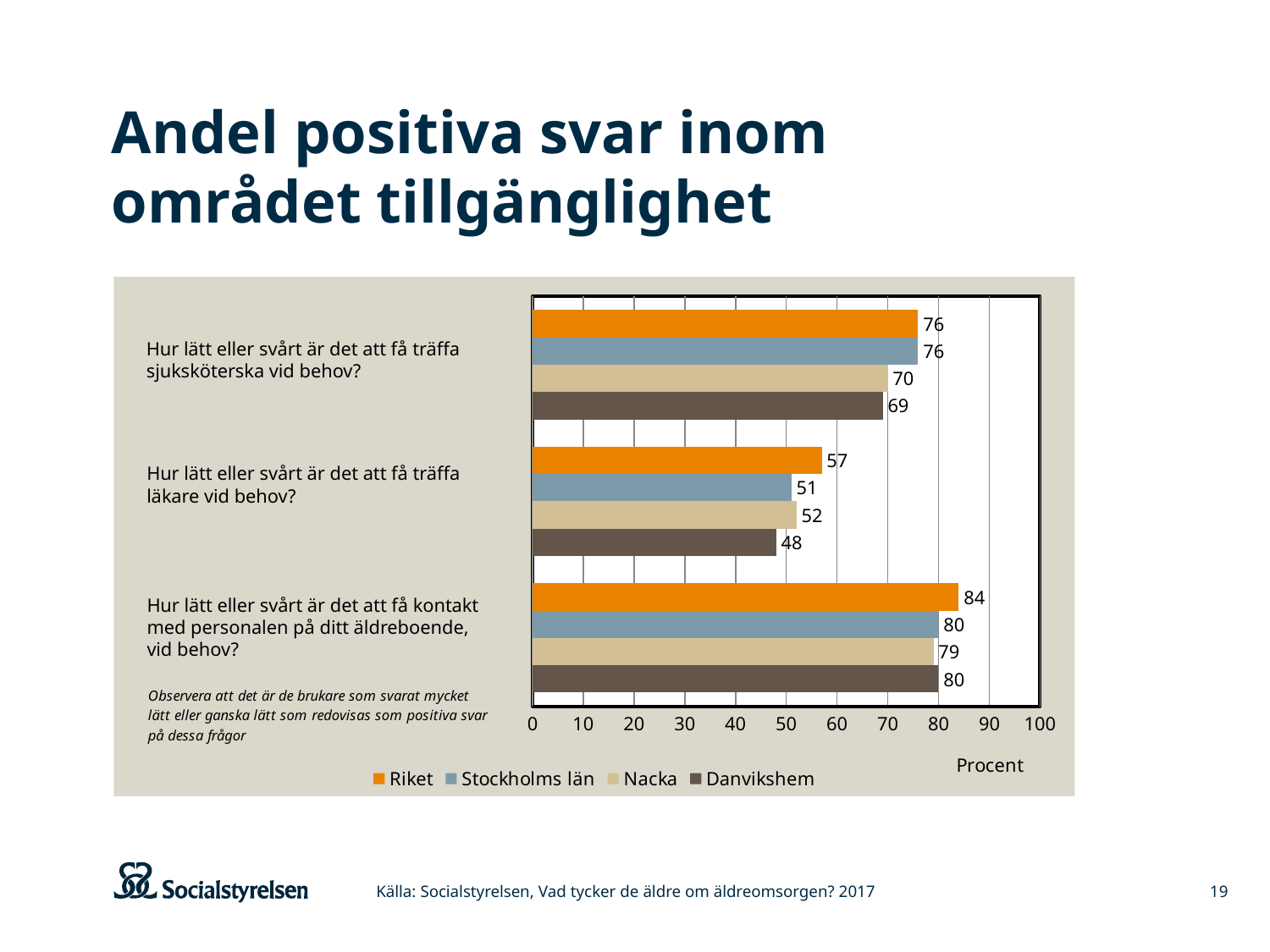
Which is larger for Danvikshem: the value for "Hur lätt eller svårt är det att få träffa sjuksköterska vid behov?" or for "Hur lätt eller svårt är det att få kontakt med personalen på ditt äldreboende, vid behov?"? Hur lätt eller svårt är det att få kontakt med personalen på ditt äldreboende, vid behov? How many series does the legend list? 4 Is the value for Stockholms län on the question "Hur lätt eller svårt är det att få träffa läkare vid behov?" greater or less than 60? less What is the value for Nacka on the question "Hur lätt eller svårt är det att få kontakt med personalen på ditt äldreboende, vid behov?"? 79 What kind of chart is shown on the slide? bar chart Which series has the highest value on the question "Hur lätt eller svårt är det att få kontakt med personalen på ditt äldreboende, vid behov?"? Riket What is the value for Riket on the question "Hur lätt eller svårt är det att få träffa läkare vid behov?"? 57 How many questions (categories) are shown on the chart? 3 Which series has the lowest value on the question "Hur lätt eller svårt är det att få träffa läkare vid behov?"? Danvikshem What is the label of the x axis? Procent What is the value for Danvikshem on the question "Hur lätt eller svårt är det att få träffa sjuksköterska vid behov?"? 69 What is the difference between Riket and Danvikshem on the question "Hur lätt eller svårt är det att få träffa läkare vid behov?"? 9